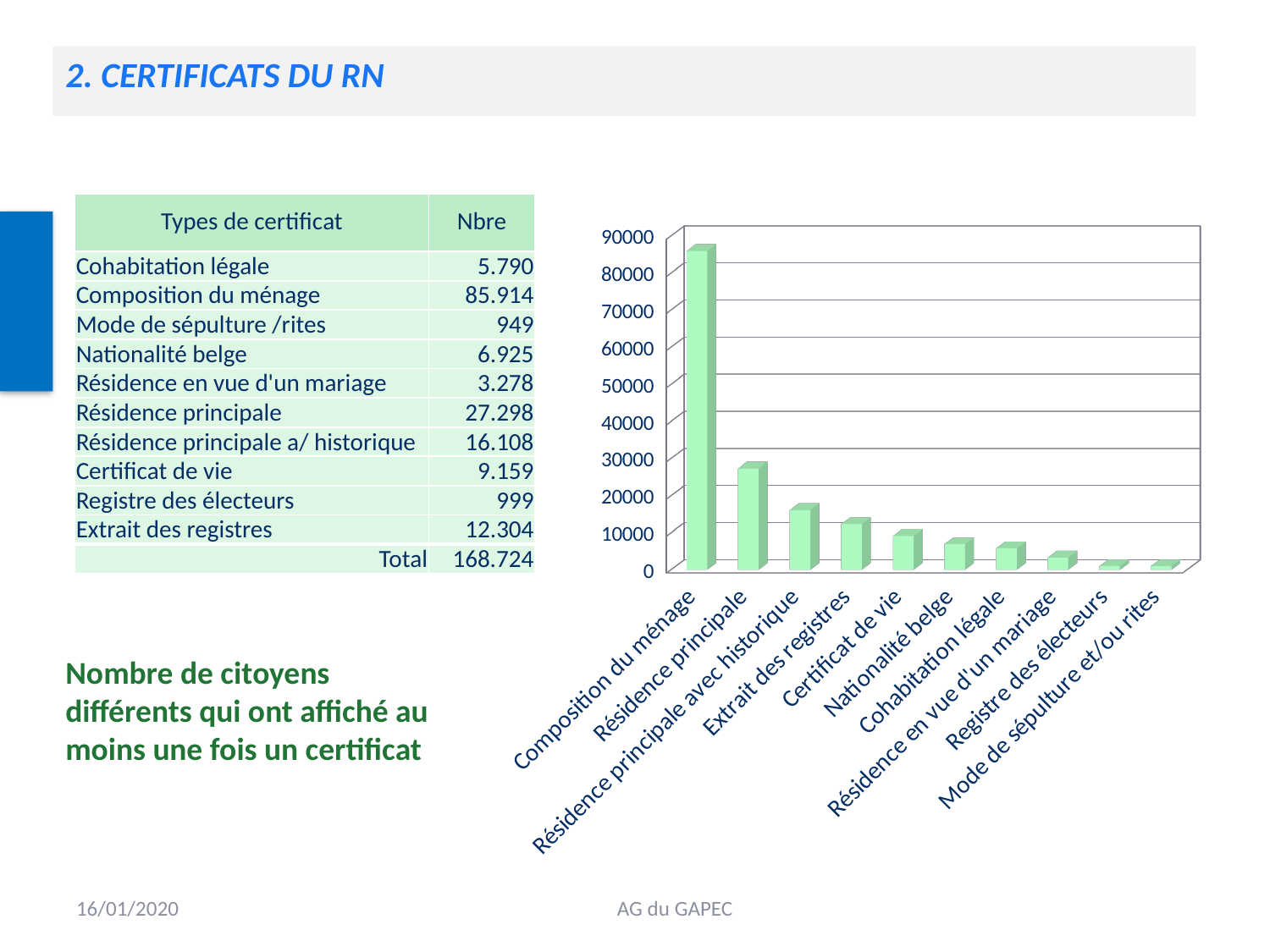
According to the table, what is the number (Nbre) for Composition du ménage? 85.914 Which category has the highest bar in the chart? Composition du ménage Using the table values, what is the difference between Résidence principale and Résidence principale a/ historique? 11.190 Which is larger, the bar for Certificat de vie or the bar for Nationalité belge? Certificat de vie What is the total shown in the table for all certificate types? 168.724 What kind of chart is shown on the slide? bar chart Do the bar values rise or fall from left to right along the x axis? fall How many categories are plotted in the chart? 10 Is the value for Résidence principale greater or less than 30000? less According to the table, what is the number (Nbre) for Résidence principale? 27.298 Is the value for Composition du ménage greater or less than 80000? greater Is the value for Extrait des registres greater or less than 10000? greater